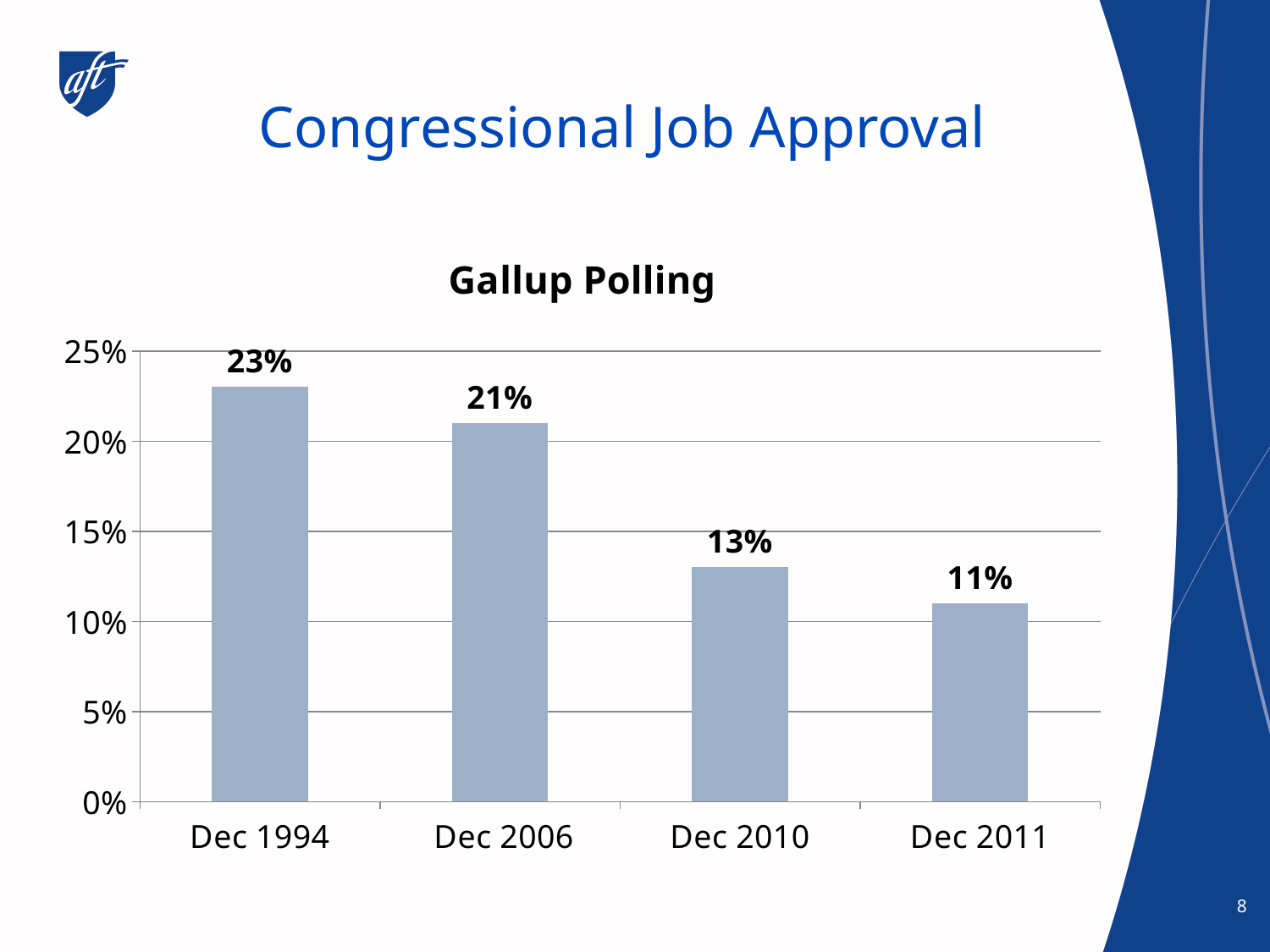
Which is larger, the value for Dec 2006 or the value for Dec 2010? Dec 2006 What is the value for Dec 1994? 23% How many categories are shown on the x axis? 4 What is the difference between the values for Dec 2006 and Dec 2010? 8% Which category has the highest value? Dec 1994 What is the difference between the values for Dec 1994 and Dec 2011? 12% Which category has the lowest value? Dec 2011 Do the values rise or fall from Dec 1994 to Dec 2011? fall What is the value for Dec 2010? 13% Is the value for Dec 2006 greater or less than 20%? greater What kind of chart is shown on the slide? bar chart What is the value for Dec 2011? 11%